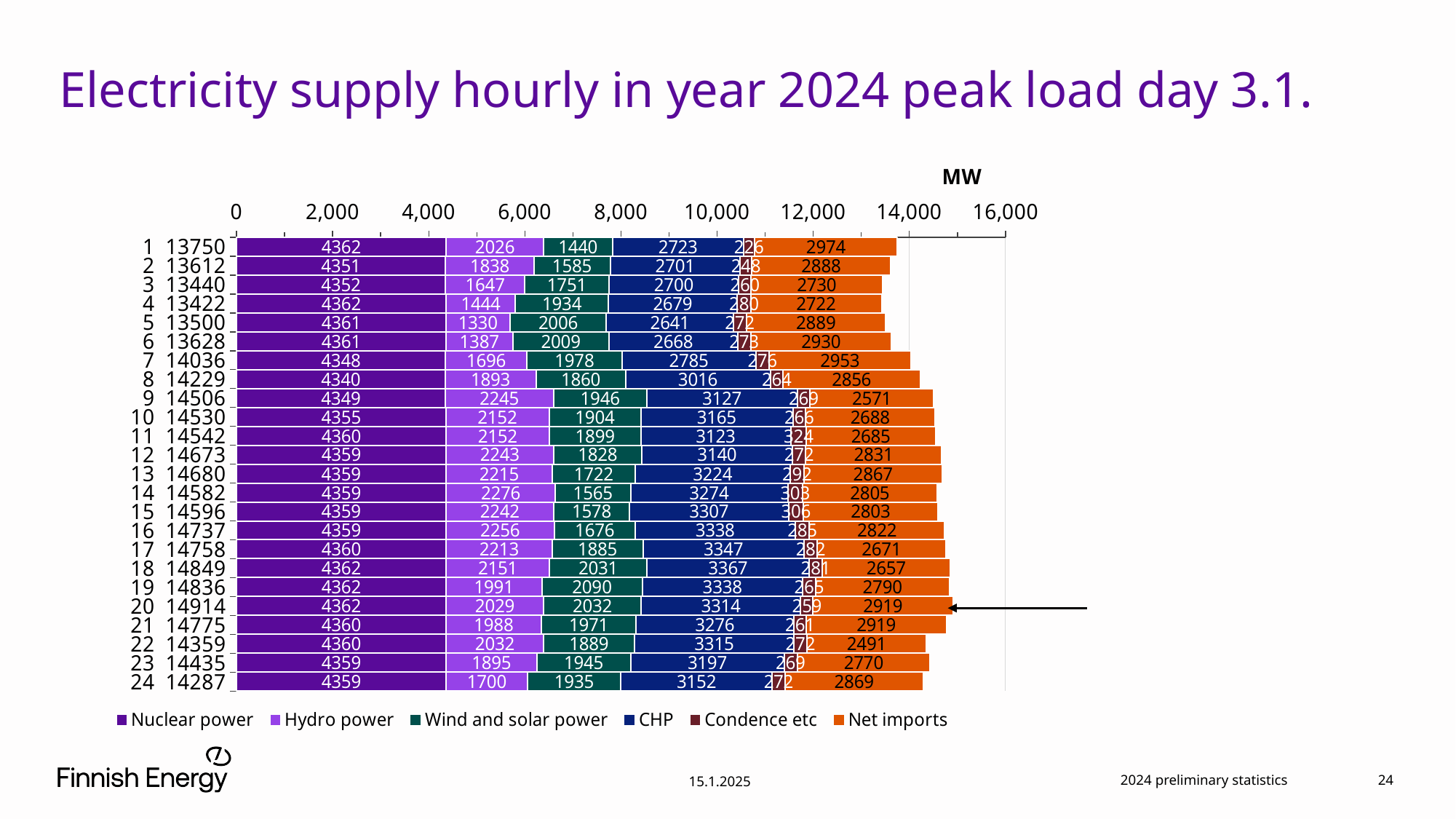
What is the total electricity supply for hour 20? 14914 What is the Net imports value for hour 22? 2491 How many hours (categories) are shown in the chart? 24 Which hour has the highest total electricity supply? 20 What is the difference between the Net imports value for hour 1 and for hour 22? 483 What kind of chart is shown on the slide? stacked bar chart Which is larger, the CHP value for hour 18 or for hour 1? hour 18 What is the Hydro power value for hour 9? 2245 How many series does the legend list? 6 What is the Wind and solar power value for hour 19? 2090 What is the Nuclear power value for hour 1? 4362 Which hour has the lowest total electricity supply? 4